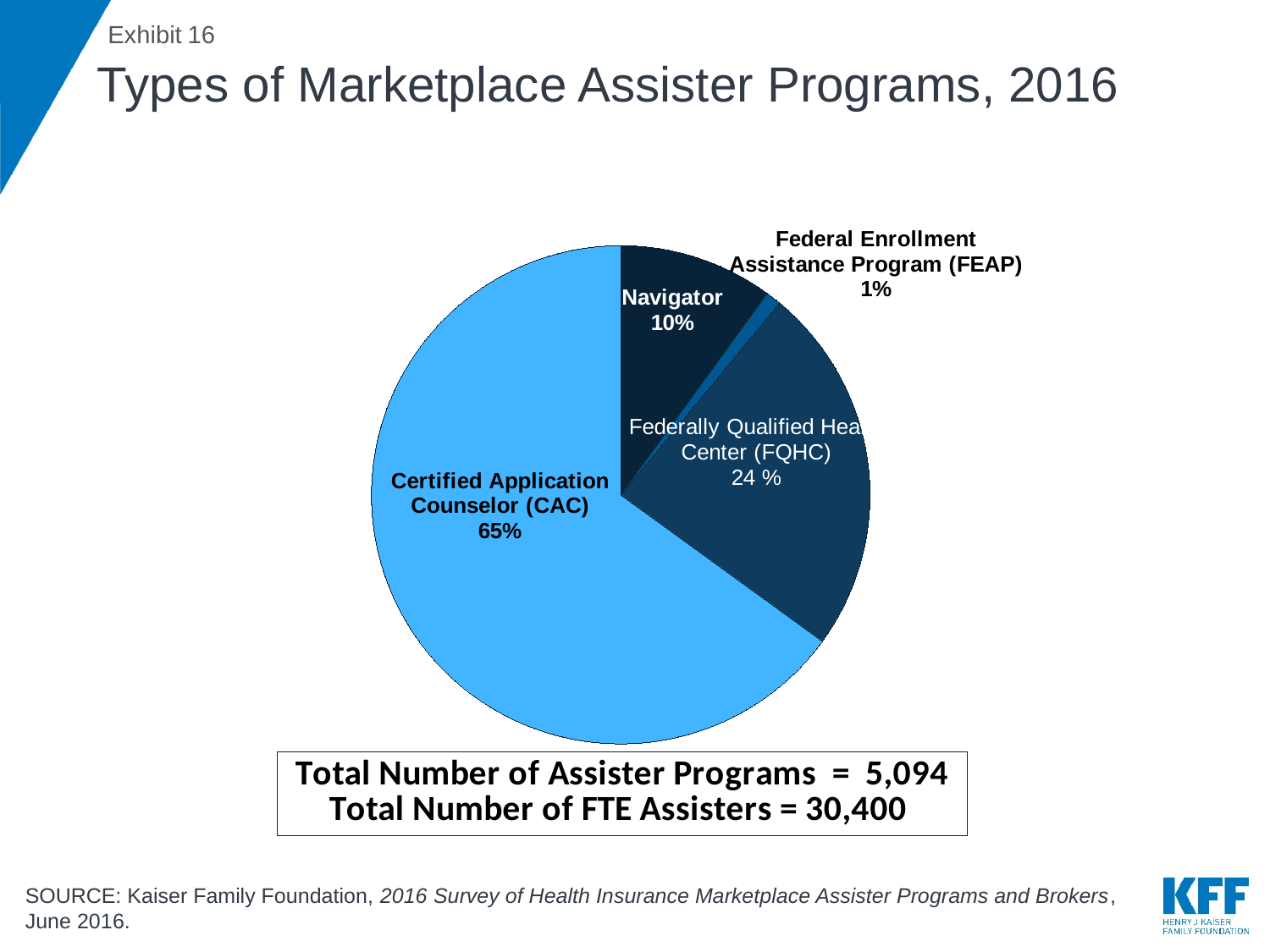
How many slices does the pie chart have? 4 Which type of assister program has the smallest share of the pie? Federal Enrollment Assistance Program (FEAP) What share of assister programs are Federally Qualified Health Center (FQHC) programs? 24 % Which has a larger share of assister programs, Navigator or FQHC? FQHC What is the difference in percentage points between the CAC share and the FQHC share? 41 percentage points What is the total number of assister programs stated on the slide? 5,094 What type of chart is shown on the slide? Pie chart Which type of assister program has the largest share of the pie? Certified Application Counselor (CAC) What share of Marketplace assister programs are Certified Application Counselor (CAC) programs? 65% What is the title of the chart? Types of Marketplace Assister Programs, 2016 What percentage of assister programs are Navigator programs? 10% What percentage of assister programs are Federal Enrollment Assistance Program (FEAP) programs? 1%